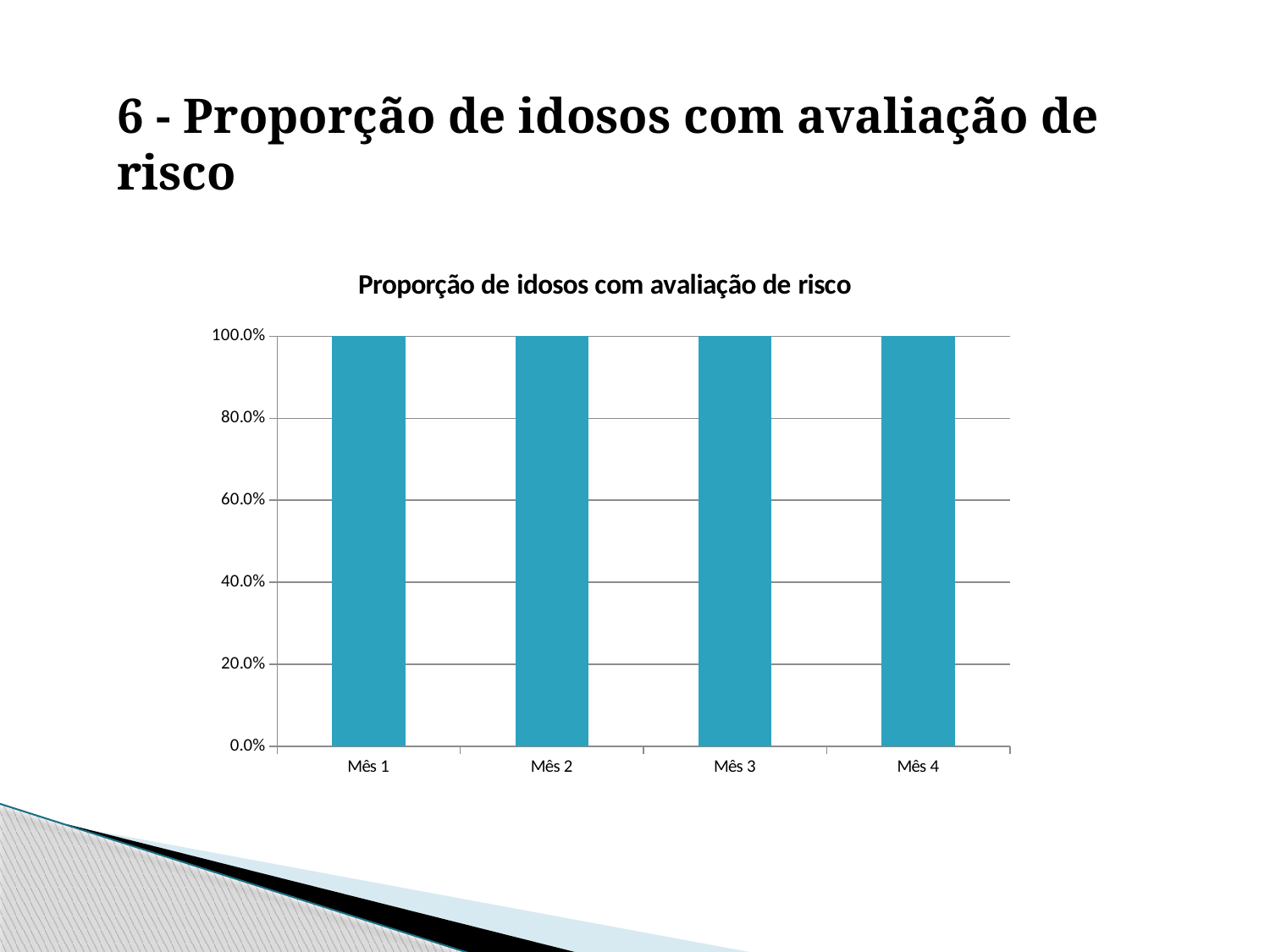
What is the highest value shown on the y axis of the chart? 100.0% How many categories are plotted on the x axis of the chart? 4 What kind of chart is shown on the slide? bar chart What is the title of the chart? Proporção de idosos com avaliação de risco What is the value for Mês 1? 100.0% What is the difference between the values for Mês 1 and Mês 3? 0.0% Do the values rise, fall, or stay the same from Mês 1 to Mês 4? stay the same What is the value for Mês 2? 100.0% Is the value for Mês 4 greater or less than 60.0%? greater What is the value for Mês 3? 100.0% Is the value for Mês 2 greater or less than 80.0%? greater What is the value for Mês 4? 100.0%